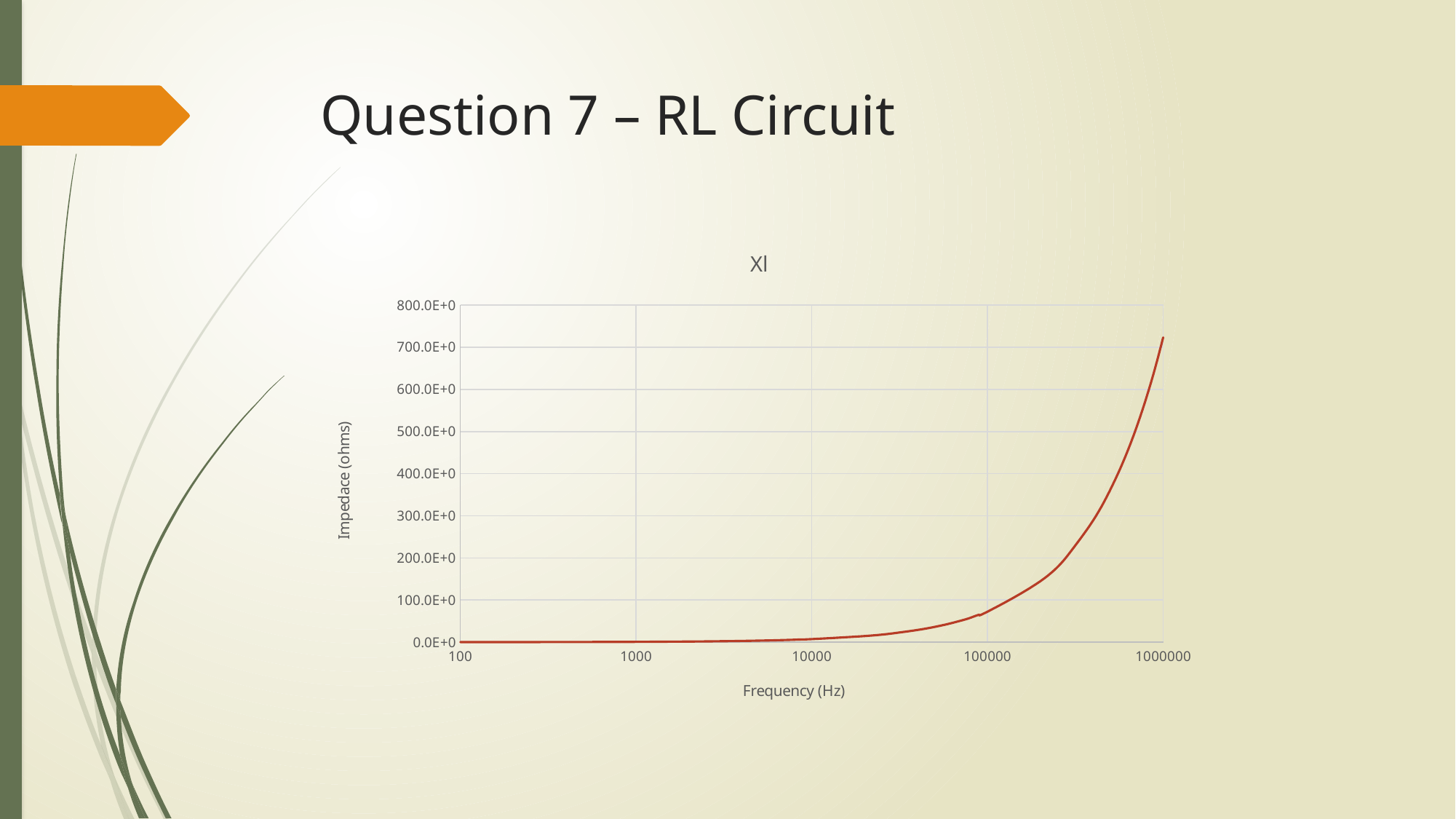
Is the impedance at 10000 Hz greater or less than 100.0E+0 ohms? less Does the impedance rise or fall as frequency increases along the x axis? rise Is the impedance at 1000000 Hz greater or less than 600.0E+0 ohms? greater At which labelled frequency on the x axis is the impedance highest? 1000000 What is the title of the chart? Xl Which has the larger impedance, 100000 Hz or 1000000 Hz? 1000000 Hz Is the impedance at 1000000 Hz greater or less than 800.0E+0 ohms? less What is the label of the y axis? Impedace (ohms) What kind of chart is shown on the slide? line chart At which labelled frequency on the x axis is the impedance lowest? 100